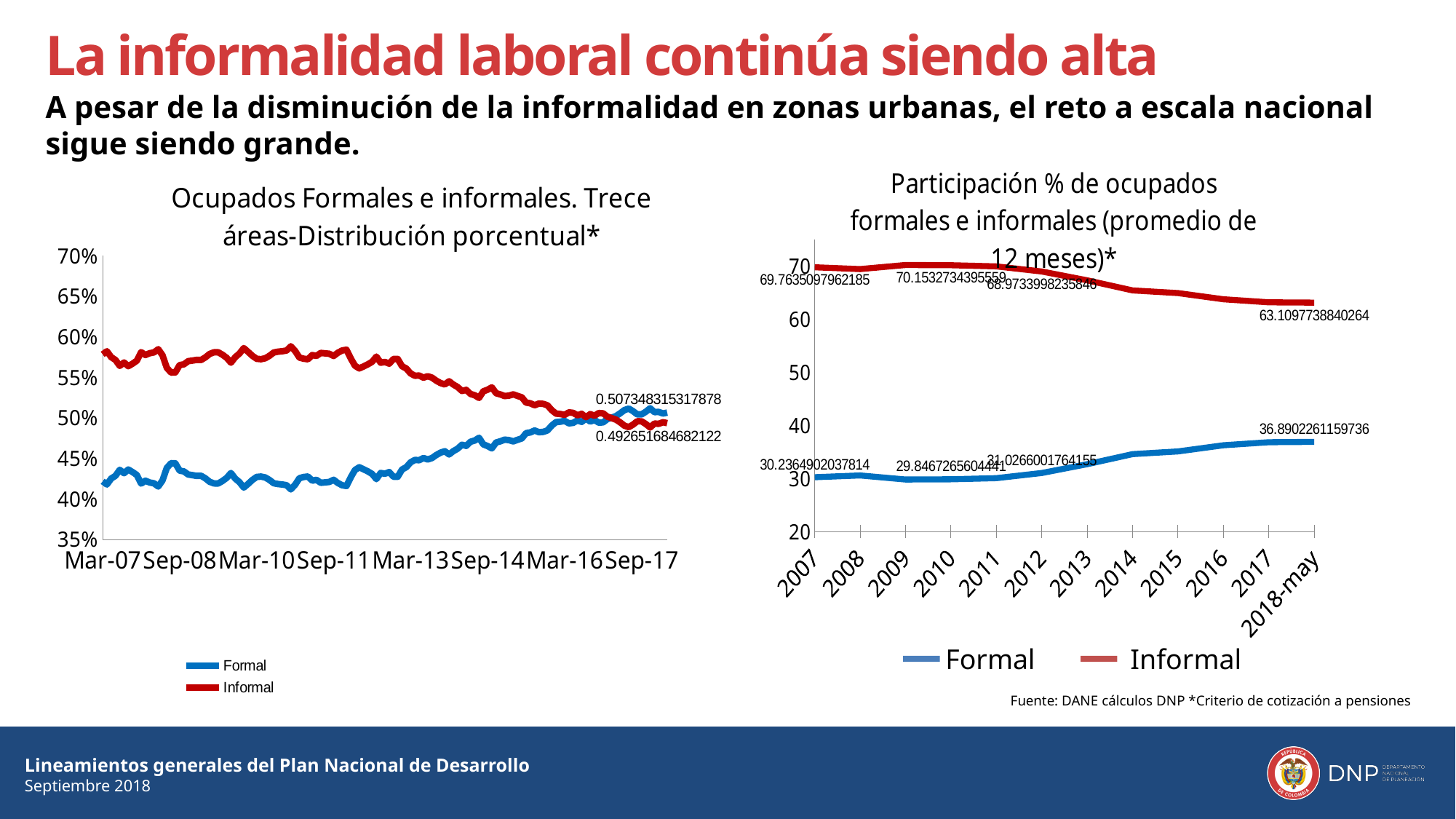
In the left chart 'Ocupados Formales e informales. Trece áreas-Distribución porcentual*', what is the last data label shown for the Formal series? 0.507348315317878 In the right chart 'Participación % de ocupados formales e informales (promedio de 12 meses)*', how many series does the legend list? 2 What type of chart is the left chart titled 'Ocupados Formales e informales. Trece áreas-Distribución porcentual*'? line chart In the right chart 'Participación % de ocupados formales e informales (promedio de 12 meses)*', is the Formal value for 2016 greater or less than 30? greater In the right chart 'Participación % de ocupados formales e informales (promedio de 12 meses)*', what is the value of the Informal series for 2018-may? 63.1097738840264 In the right chart 'Participación % de ocupados formales e informales (promedio de 12 meses)*', what is the value of the Formal series for 2018-may? 36.8902261159736 In the right chart 'Participación % de ocupados formales e informales (promedio de 12 meses)*', what is the value of the Informal series for 2007? 69.7635097962185 In the left chart 'Ocupados Formales e informales. Trece áreas-Distribución porcentual*', which colour represents the Informal series? red In the right chart 'Participación % de ocupados formales e informales (promedio de 12 meses)*', does the Informal series rise or fall from 2007 to 2018-may? fall In the right chart 'Participación % de ocupados formales e informales (promedio de 12 meses)*', which series has the higher value in 2015, Formal or Informal? Informal In the left chart 'Ocupados Formales e informales. Trece áreas-Distribución porcentual*', is the Informal value at Mar-10 greater or less than 55%? greater